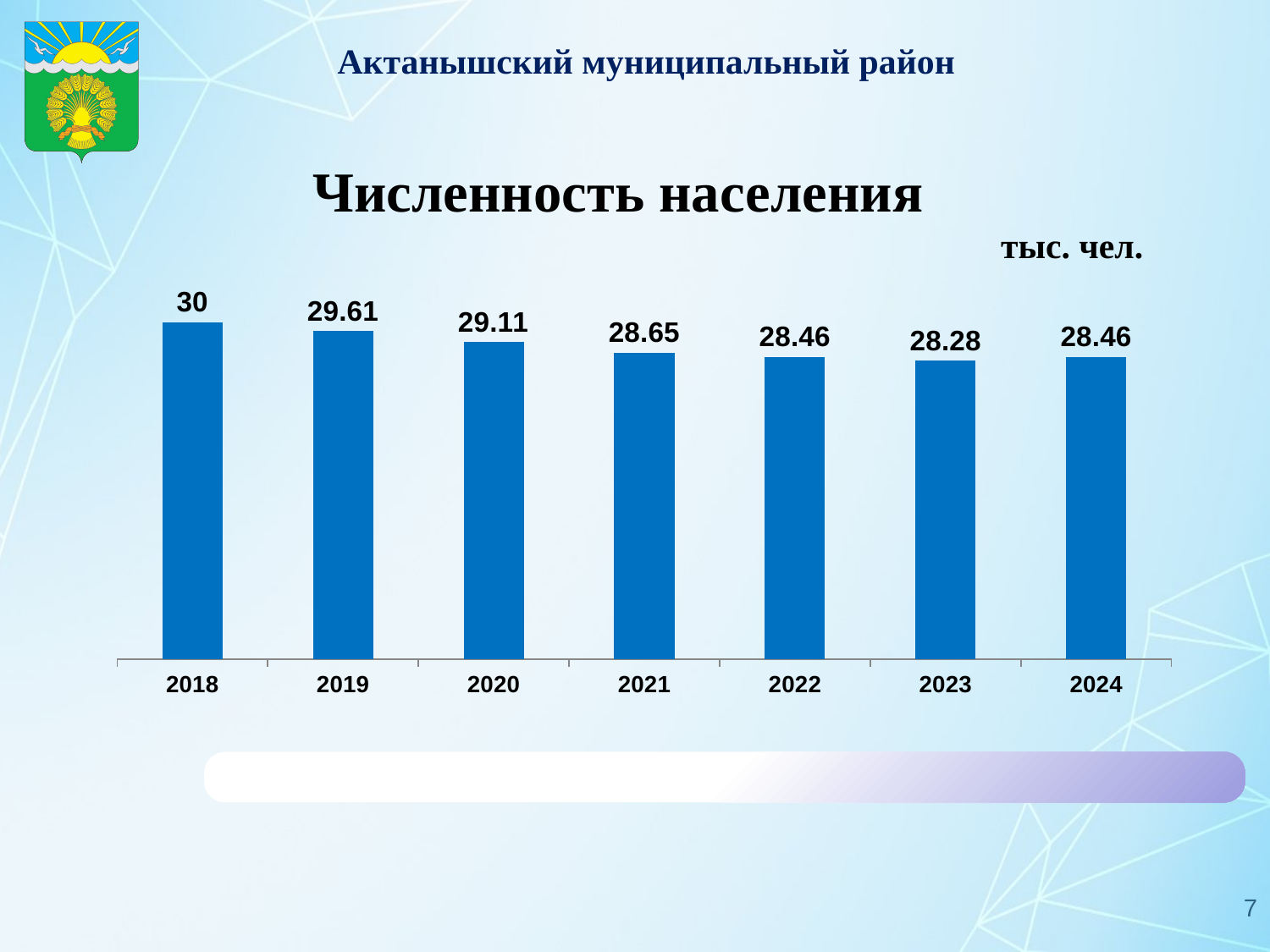
What unit is indicated for the values on the chart? тыс. чел. Which year has the lowest population value? 2023 Which year has the highest population value? 2018 What is the population value shown for 2021? 28.65 How many years are shown on the chart? 7 What is the population value shown for 2024? 28.46 What kind of chart is shown on the slide? bar chart Which year has a larger population value, 2019 or 2021? 2019 What is the difference between the population values for 2020 and 2023? 0.83 Do the population values generally rise or fall from 2018 to 2023? fall What is the population value shown for 2018? 30 What is the difference between the population values for 2018 and 2019? 0.39